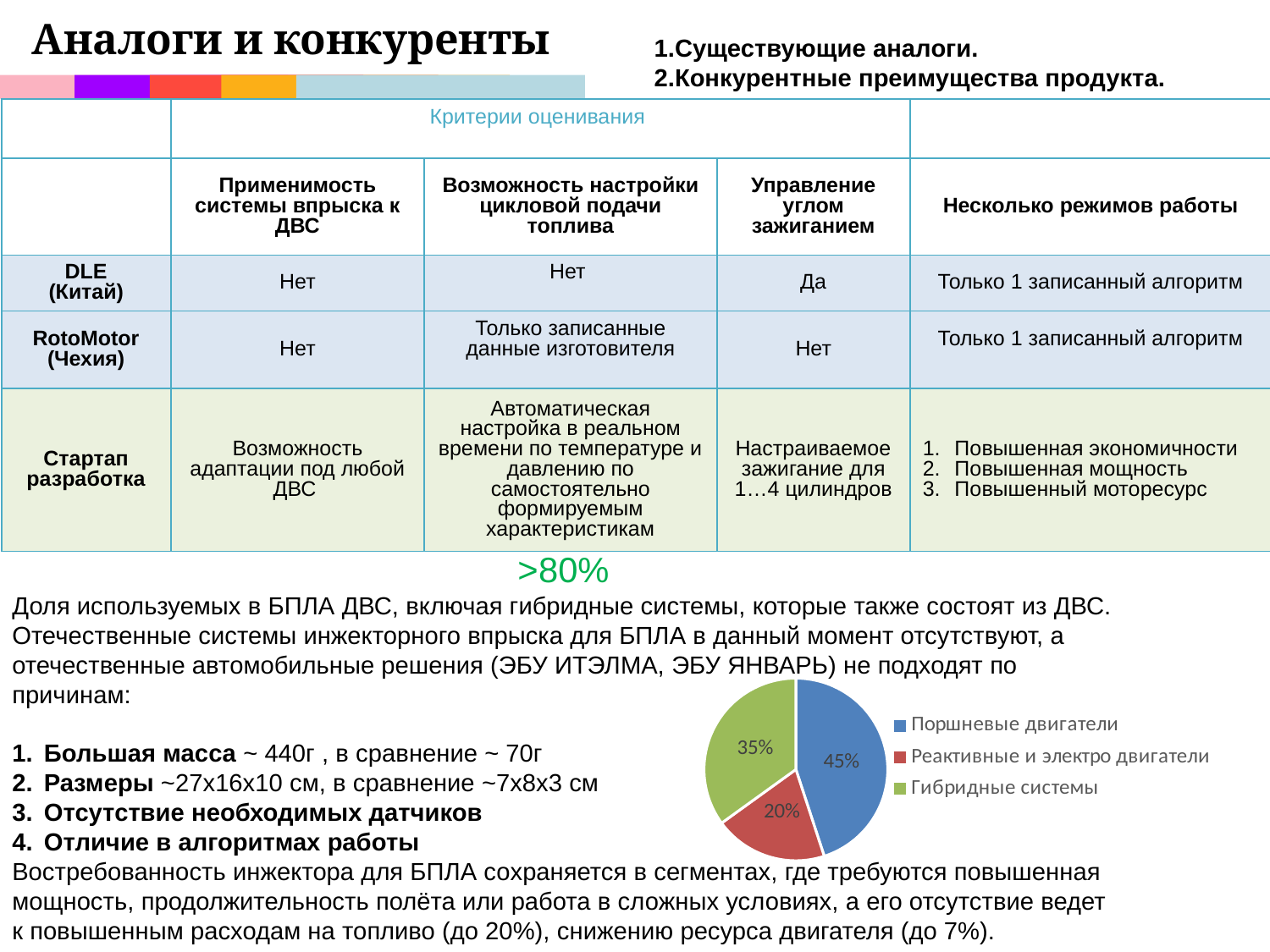
What is the difference in percentage points between the Поршневые двигатели slice and the Гибридные системы slice? 10 Which slice is larger in the pie chart: Гибридные системы or Реактивные и электро двигатели? Гибридные системы What share of the pie chart is labelled for Гибридные системы? 35% What colour is the Поршневые двигатели slice in the pie chart? blue What kind of chart is shown on the slide? pie chart What share of the pie chart is labelled for Реактивные и электро двигатели? 20% Which category has the largest slice in the pie chart? Поршневые двигатели How many slices does the pie chart have? 3 Which category has the smallest slice in the pie chart? Реактивные и электро двигатели What share of the pie chart is labelled for Поршневые двигатели? 45% What colour is the Гибридные системы slice in the pie chart? green How many entries does the pie chart legend list? 3